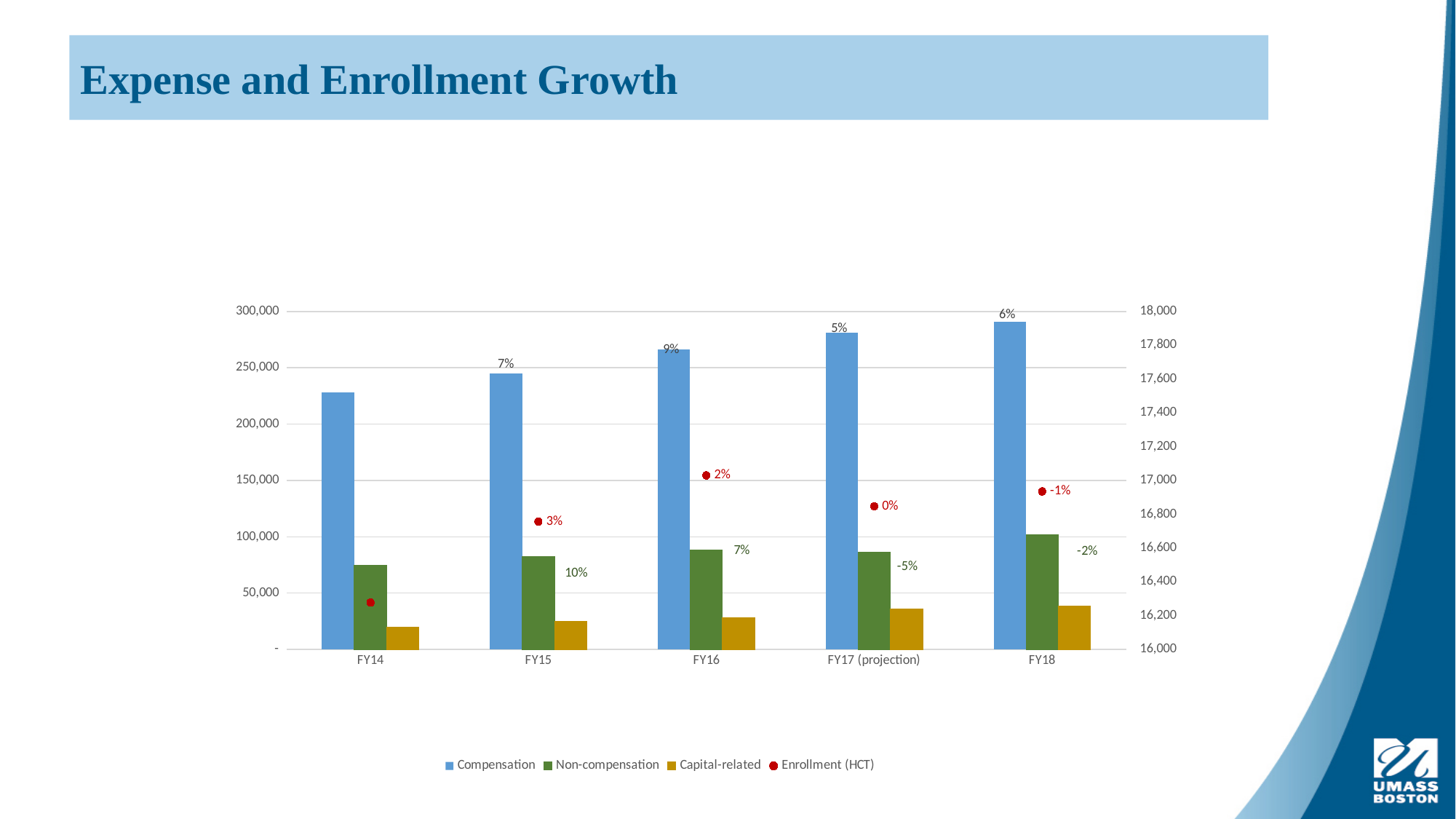
In which fiscal year is the Compensation bar the tallest? FY18 How many fiscal years are shown on the x axis? 5 Is the Capital-related value for FY18 greater or less than 50,000? less Which is larger in FY16, the Non-compensation bar or the Capital-related bar? Non-compensation How many series does the legend list? 4 Is the Compensation value for FY14 greater or less than 250,000? less What growth percentage is labeled on the Non-compensation bar for FY17 (projection)? -5% In which fiscal year is the Capital-related bar the shortest? FY14 Do the Compensation bars rise or fall from FY14 to FY18? rise What growth percentage is labeled on the Non-compensation bar for FY15? 10% What percentage is labeled next to the Enrollment (HCT) marker for FY18? -1% What growth percentage is labeled on the Compensation bar for FY16? 9%